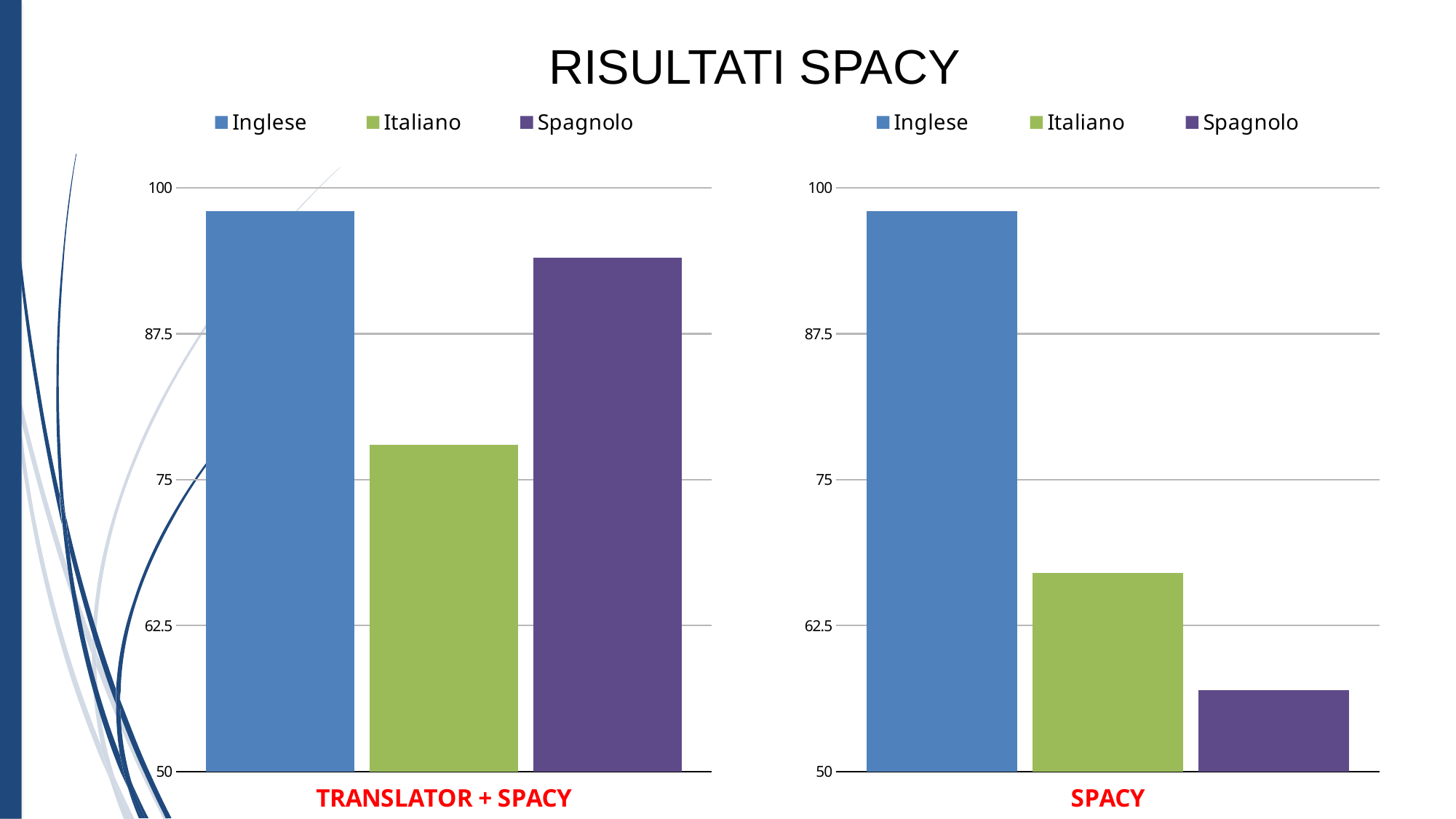
In the SPACY chart, which series has the lowest value? Spagnolo In the TRANSLATOR + SPACY chart, which is larger, the value for Spagnolo or the value for Italiano? Spagnolo In the TRANSLATOR + SPACY chart, which series has the lowest value? Italiano What kind of chart is the TRANSLATOR + SPACY chart on the left? bar chart How many bars are plotted in the TRANSLATOR + SPACY chart? 3 In the TRANSLATOR + SPACY chart, is the value for Italiano greater or less than 75? greater In the SPACY chart, is the value for Spagnolo greater or less than 62.5? less How many series does the legend of the SPACY chart on the right list? 3 In the TRANSLATOR + SPACY chart, which series has the highest value? Inglese In the SPACY chart, is the value for Italiano greater or less than 75? less In the SPACY chart, which series has the highest value? Inglese What is the title of the slide? RISULTATI SPACY